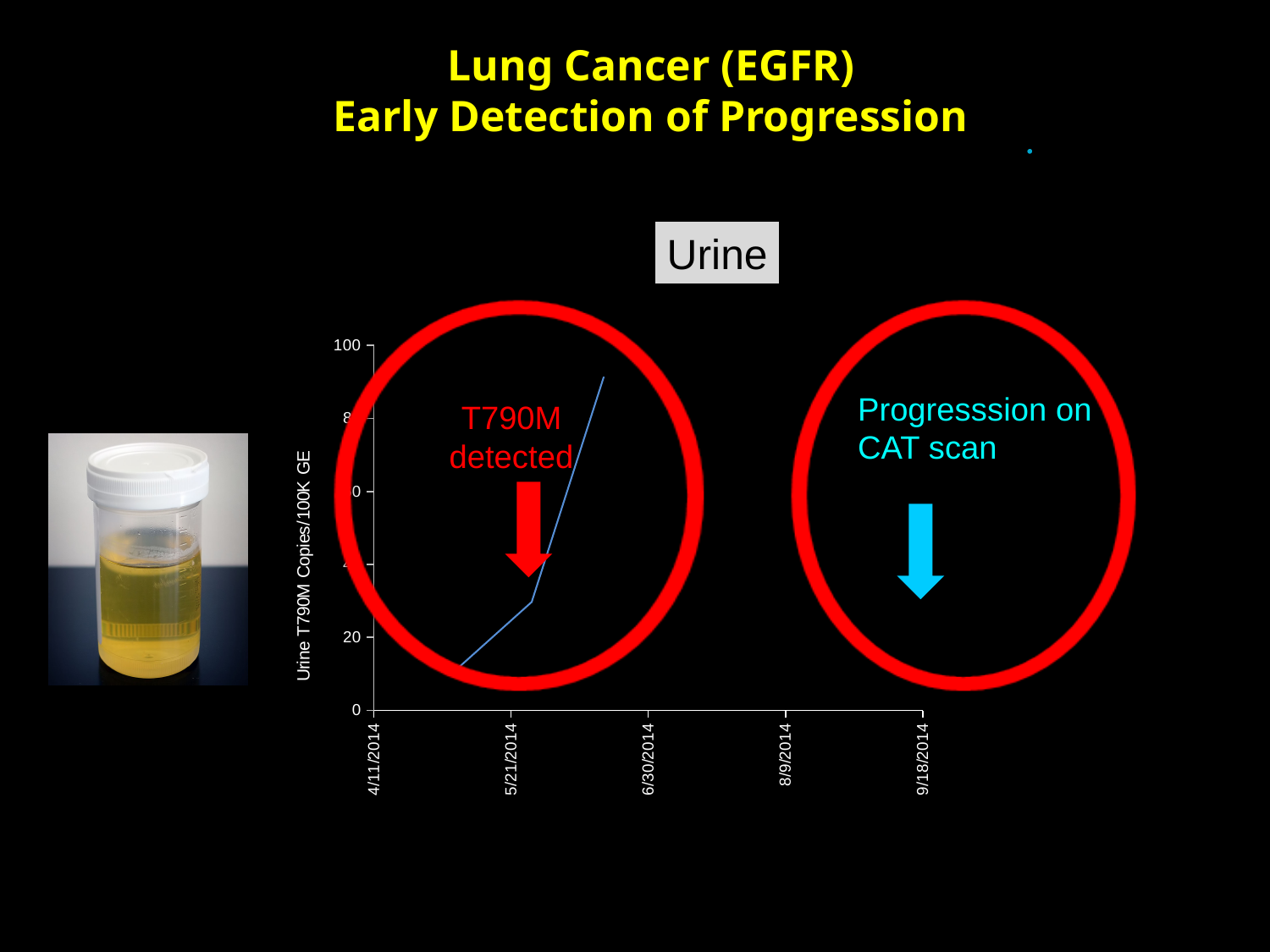
Is the highest plotted value on the line greater or less than 100? less Is the highest plotted value on the line greater or less than 80? greater What is the first date label on the x axis? 4/11/2014 What kind of chart is shown on the slide? line chart Is the first plotted value on the line greater or less than 20? less What is the maximum value shown on the vertical axis? 100 What is the last date label on the x axis? 9/18/2014 What is the title shown above the chart? Urine How many date labels are shown on the x axis of the chart? 5 What is the label on the vertical axis of the chart? Urine T790M Copies/100K GE Do the plotted values rise or fall from left to right along the x axis? rise